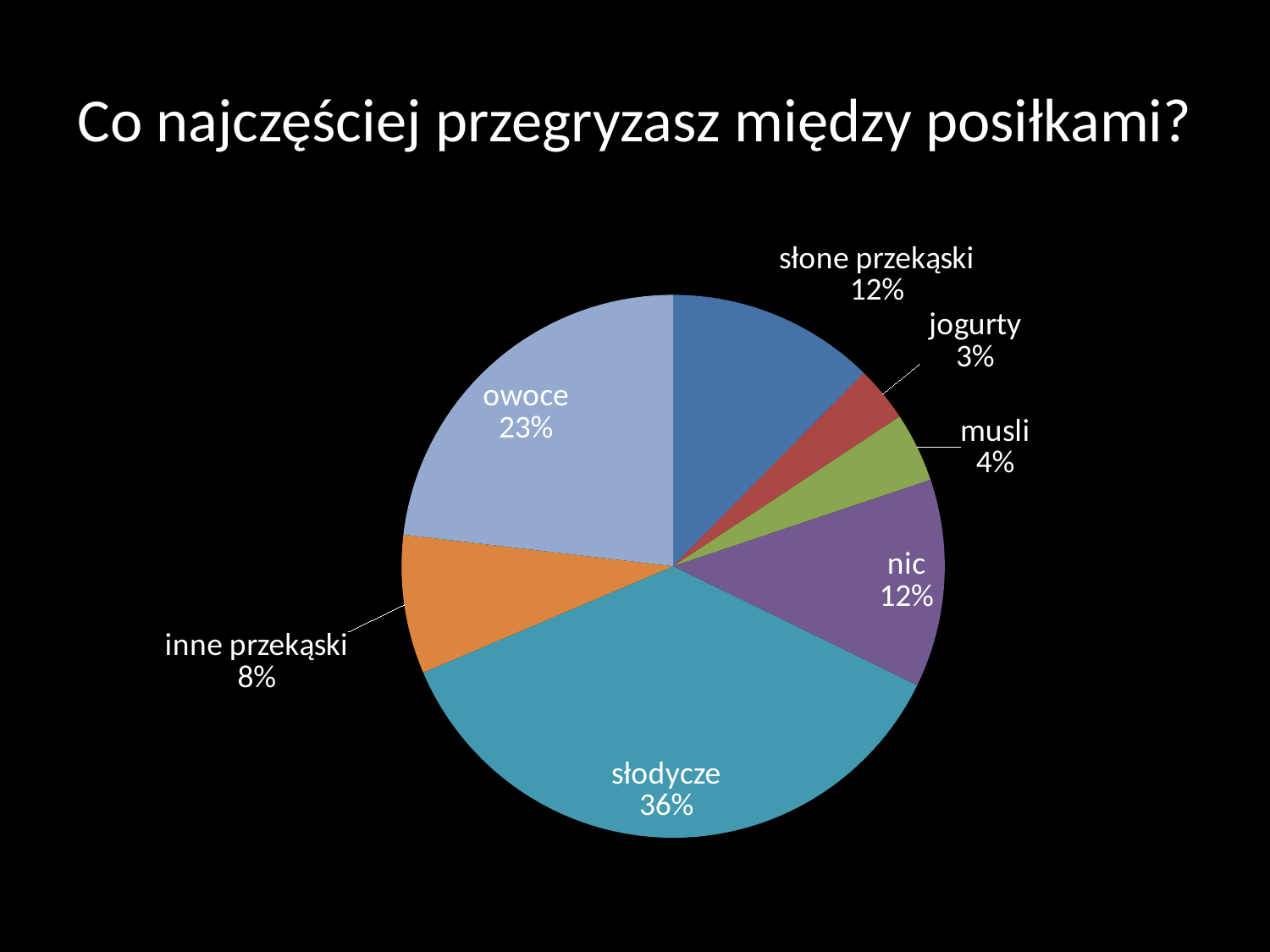
Which category has the smallest slice? jogurty What percentage is shown for 'jogurty'? 3% What is the difference between the shares of 'nic' and 'musli'? 8% What is the difference between the shares of 'słodycze' and 'owoce'? 13% Which category has the largest slice? słodycze What percentage is shown for 'inne przekąski'? 8% What percentage is shown for 'owoce'? 23% What share of the pie does 'słodycze' have? 36% What type of chart is shown on the slide? pie chart Which is larger, the share for 'musli' or the share for 'inne przekąski'? inne przekąski What is the title of the chart? Co najczęściej przegryzasz między posiłkami? How many categories are shown in the pie chart? 7